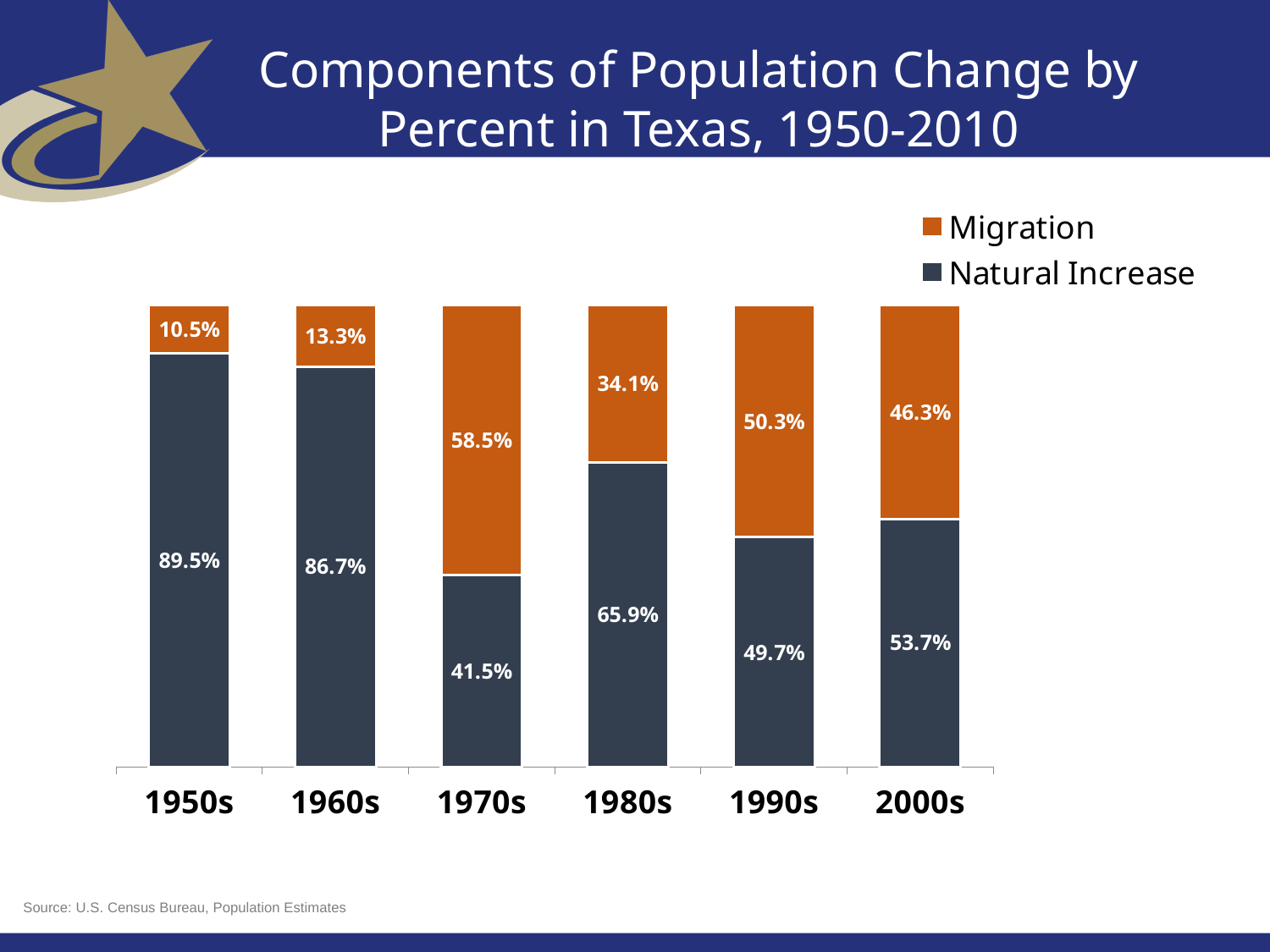
What is the difference between the Natural Increase and Migration values in the 1990s? 0.6% Which decade has the highest Migration share? 1970s Which decade has the lowest Natural Increase share? 1970s What kind of chart is shown on the slide? Stacked bar chart What is the Natural Increase value for the 1980s? 65.9% What is the Migration value for the 1970s? 58.5% How many series does the legend list? 2 What is the total of the stacked bar for the 1960s? 100% Which is larger in the 1980s, Natural Increase or Migration? Natural Increase What is the Natural Increase value for the 1950s? 89.5% What is the Migration value for the 2000s? 46.3% How many decades are shown on the x axis? 6